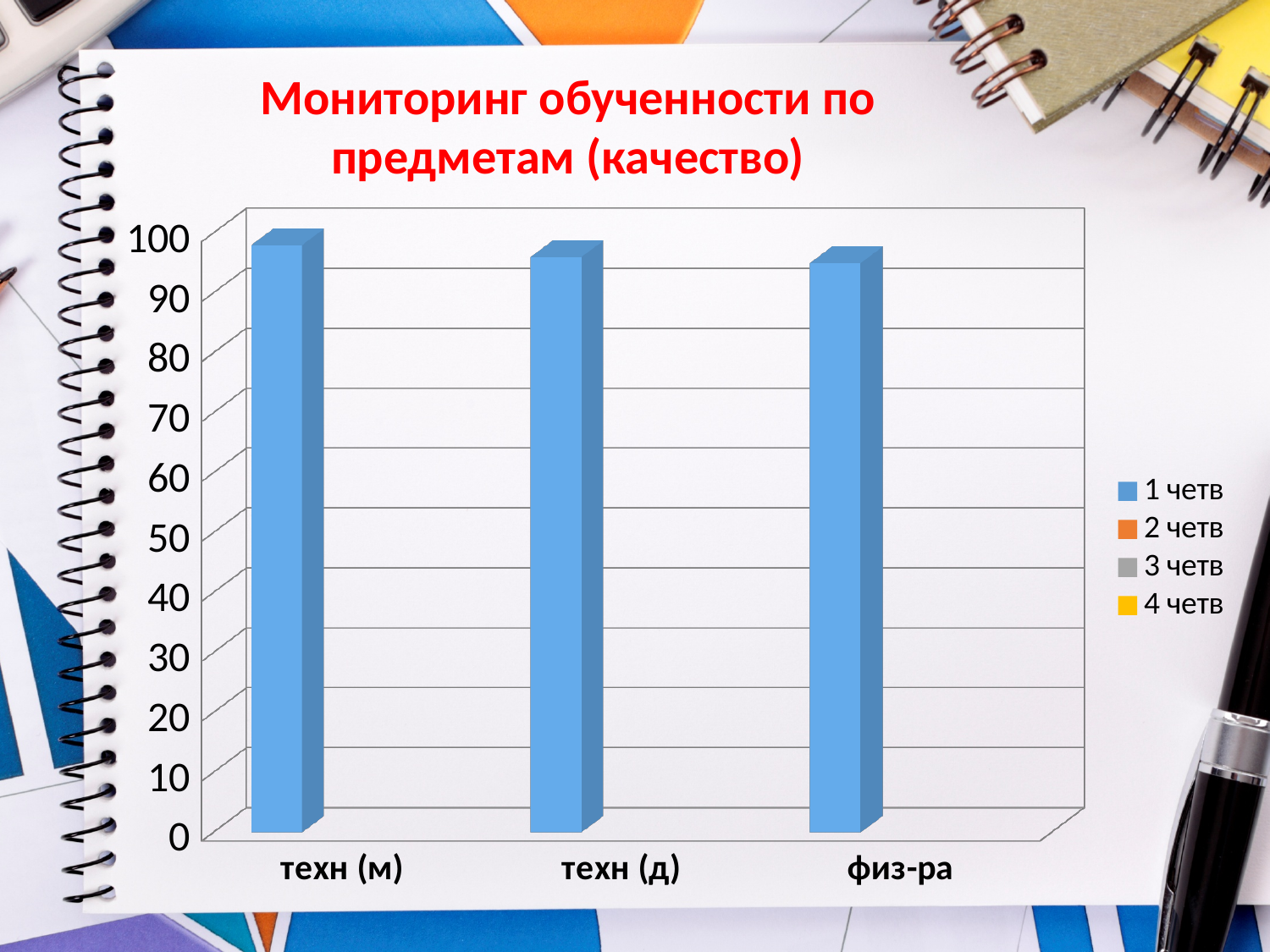
How many series does the chart's legend list? 4 Is the value for физ-ра greater or less than 90? greater Is the value for техн (м) greater or less than 90? greater Is the value for техн (м) greater or less than 50? greater What is the title of the chart? Мониторинг обученности по предметам (качество) Which legend entry corresponds to the blue bars? 1 четв What kind of chart is shown on the slide? bar chart What is the highest value shown on the vertical axis? 100 How many categories are shown on the x axis of the chart? 3